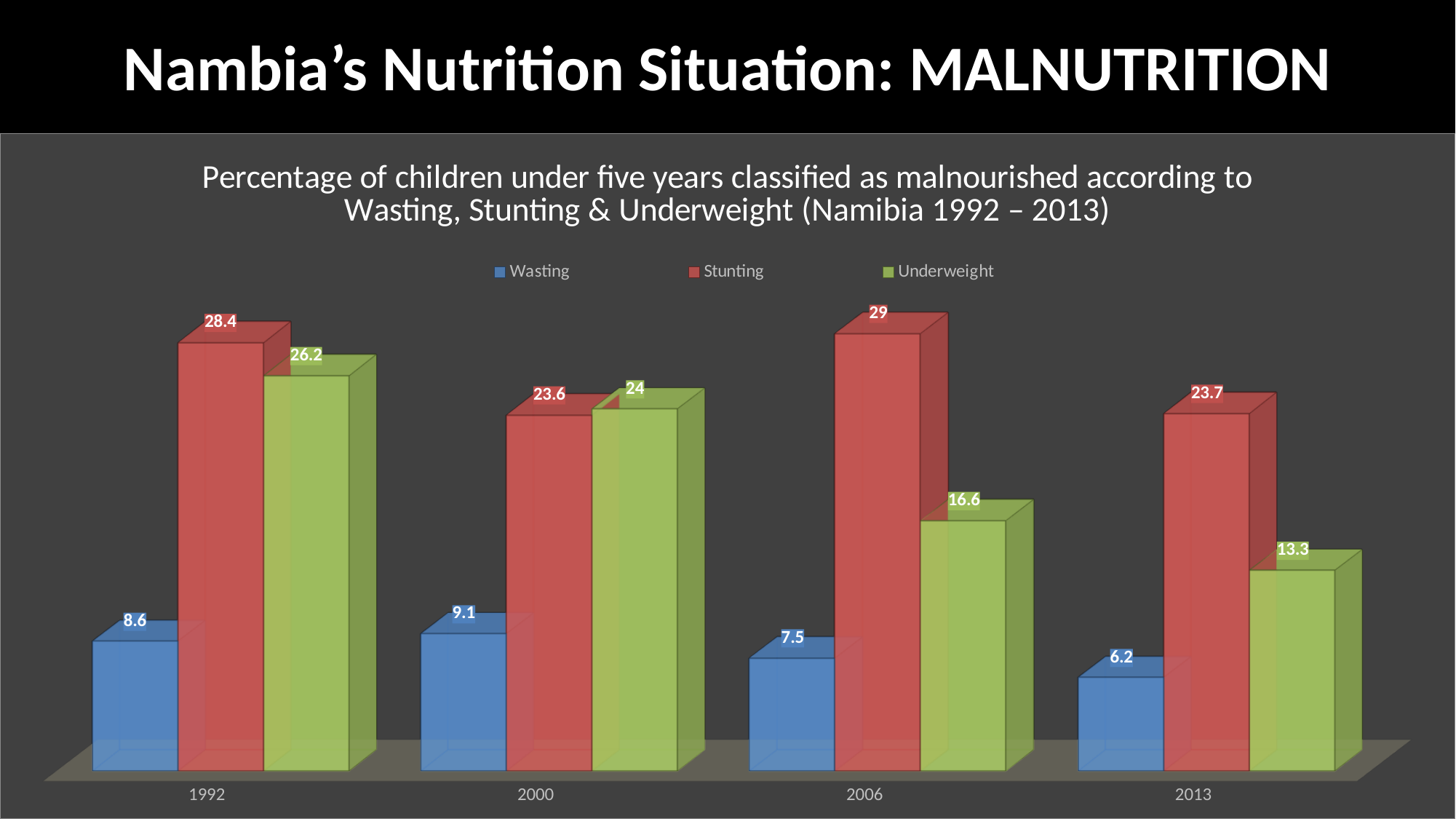
How many years are shown on the x axis? 4 What is the Wasting value for 1992? 8.6 What is the Underweight value for 2013? 13.3 In which year is the Wasting value highest? 2000 Does the Wasting value rise or fall from 2000 to 2013? fall What is the difference between the Stunting values for 2006 and 2013? 5.3 What kind of chart is shown? bar chart What is the Stunting value for 2006? 29 Which is larger, the Underweight value for 1992 or for 2000? 1992 In which year is the Underweight value lowest? 2013 How many series does the legend list? 3 Which colour represents the Stunting series? red